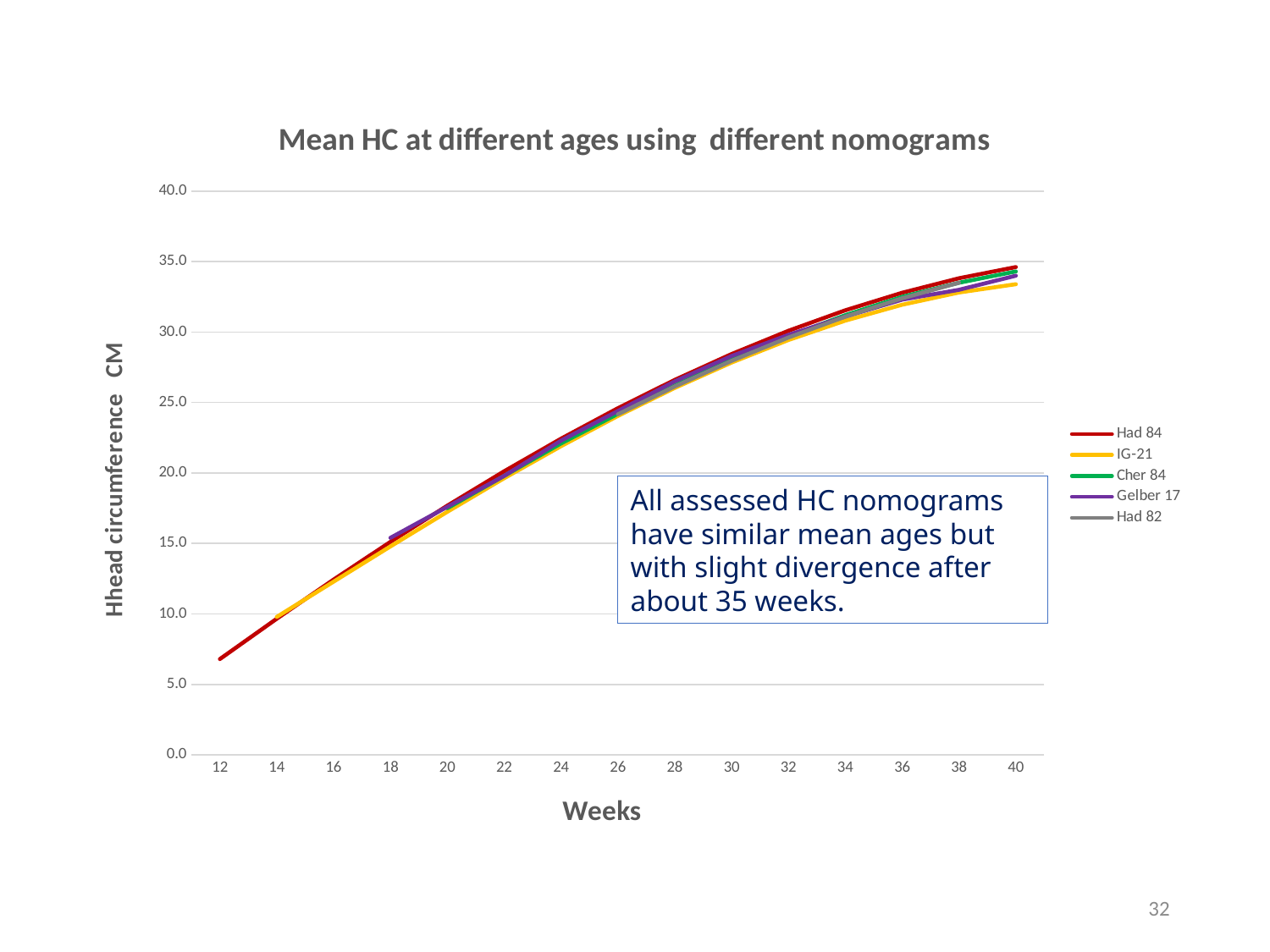
Which series has the lowest value at 40 weeks? IG-21 What is the label of the x axis? Weeks Which series has the highest value at 40 weeks? Had 84 Do the head circumference values rise or fall as the weeks increase? rise At 40 weeks, which is larger, the value for Had 84 or the value for IG-21? Had 84 What is the title of the chart? Mean HC at different ages using different nomograms Is the value for Had 84 at 40 weeks greater or less than 30.0? greater Is the value for IG-21 at 20 weeks greater or less than 20.0? less Is the value for IG-21 at 26 weeks greater or less than 20.0? greater What kind of chart is shown on the slide? line chart How many series does the legend list? 5